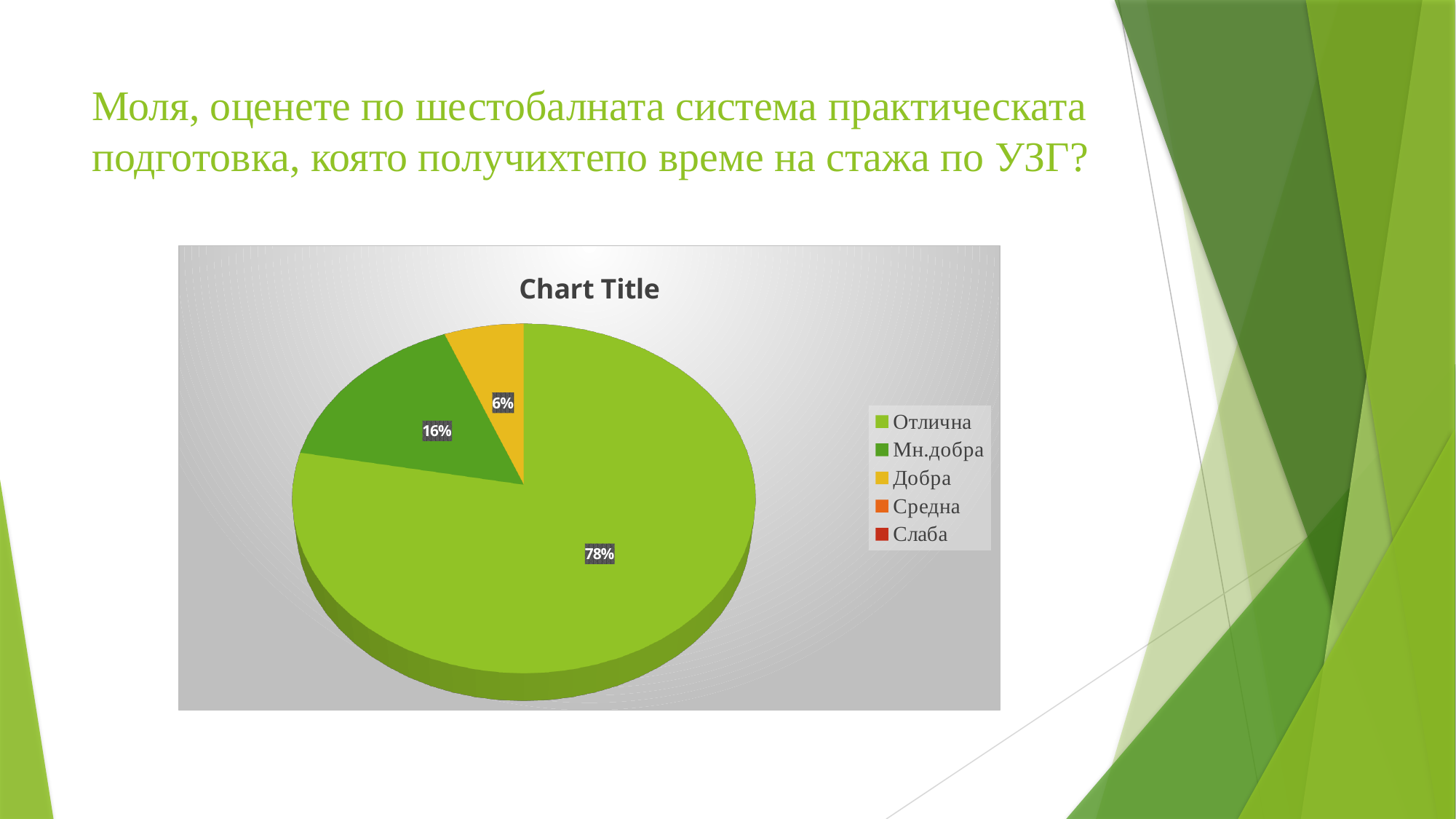
Which is larger, the slice for Мн.добра or the slice for Добра? Мн.добра What share of the pie does Отлична have? 78% What is the difference between the shares of Отлична and Мн.добра? 62% What colour is the slice for Добра? yellow What kind of chart is shown on the slide? pie chart What is the difference between the shares of Мн.добра and Добра? 10% What is the title of the chart? Chart Title Which of the labelled slices is the smallest? Добра What share of the pie does Мн.добра have? 16% What share of the pie does Добра have? 6% How many entries does the legend list? 5 Which category has the largest slice of the pie? Отлична